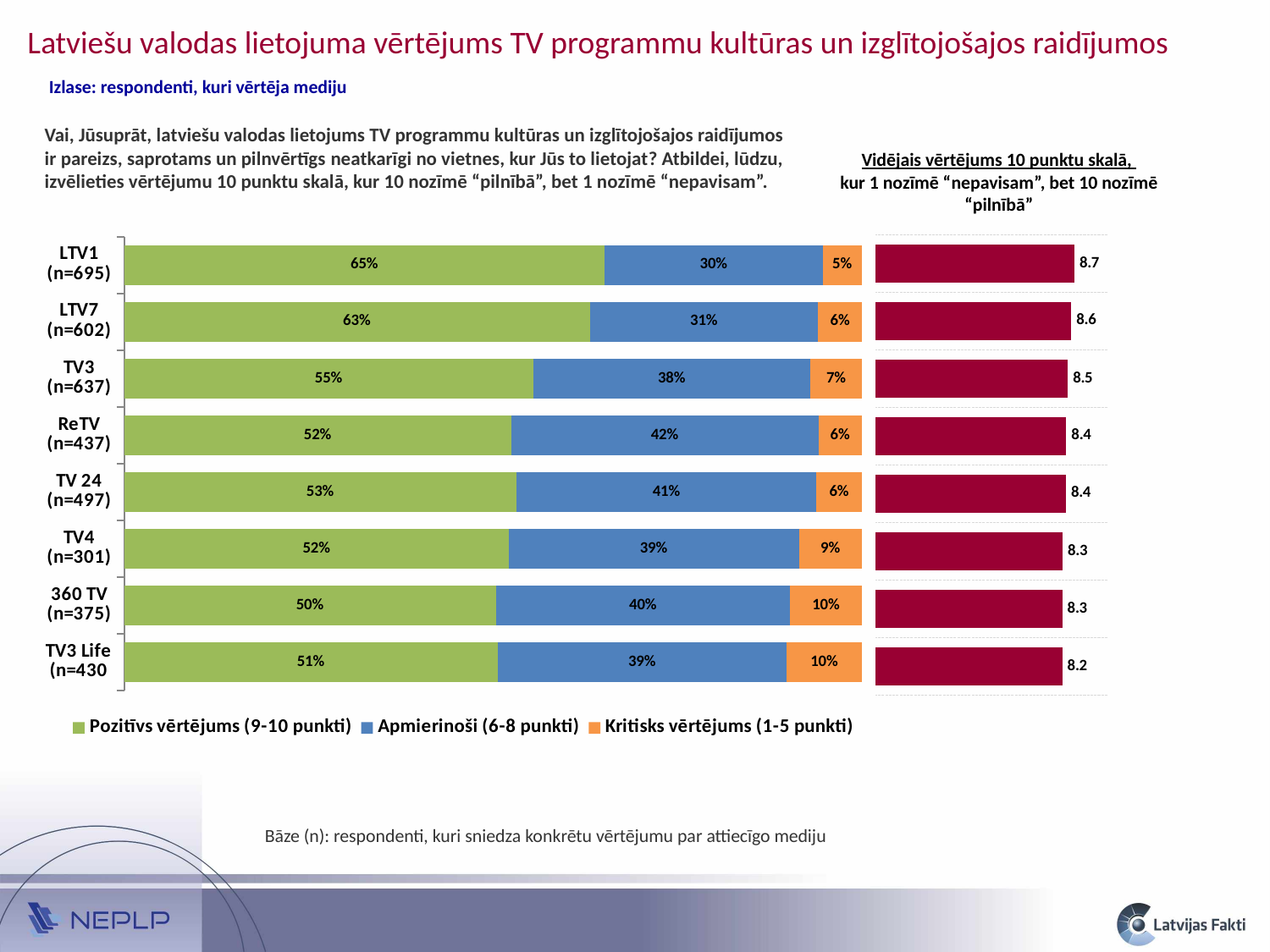
In the stacked bar chart on the left, which is larger: the "Apmierinoši (6-8 punkti)" value for TV3 (n=637) or for TV4 (n=301)? TV4 (n=301) What kind of chart is the chart on the right titled "Vidējais vērtējums 10 punktu skalā"? Bar chart In the stacked bar chart on the left, what is the value of "Apmierinoši (6-8 punkti)" for ReTV (n=437)? 42% In the stacked bar chart on the left, which channel has the lowest "Kritisks vērtējums (1-5 punkti)" share? LTV1 (n=695) In the stacked bar chart on the left, what is the value of "Kritisks vērtējums (1-5 punkti)" for 360 TV (n=375)? 10% In the stacked bar chart on the left, which channel has the highest "Pozitīvs vērtējums (9-10 punkti)" share? LTV1 (n=695) In the chart on the right titled "Vidējais vērtējums 10 punktu skalā", what is the average rating for TV3 Life (n=430)? 8.2 In the stacked bar chart on the left, what is the value of "Pozitīvs vērtējums (9-10 punkti)" for LTV1 (n=695)? 65% In the chart on the right titled "Vidējais vērtējums 10 punktu skalā", which channel has the highest average rating? LTV1 (n=695) How many series does the legend of the stacked bar chart on the left list? 3 In the stacked bar chart on the left, what is the difference between the "Pozitīvs vērtējums (9-10 punkti)" values for LTV7 (n=602) and TV3 (n=637)? 8% How many channels are shown in the stacked bar chart on the left? 8